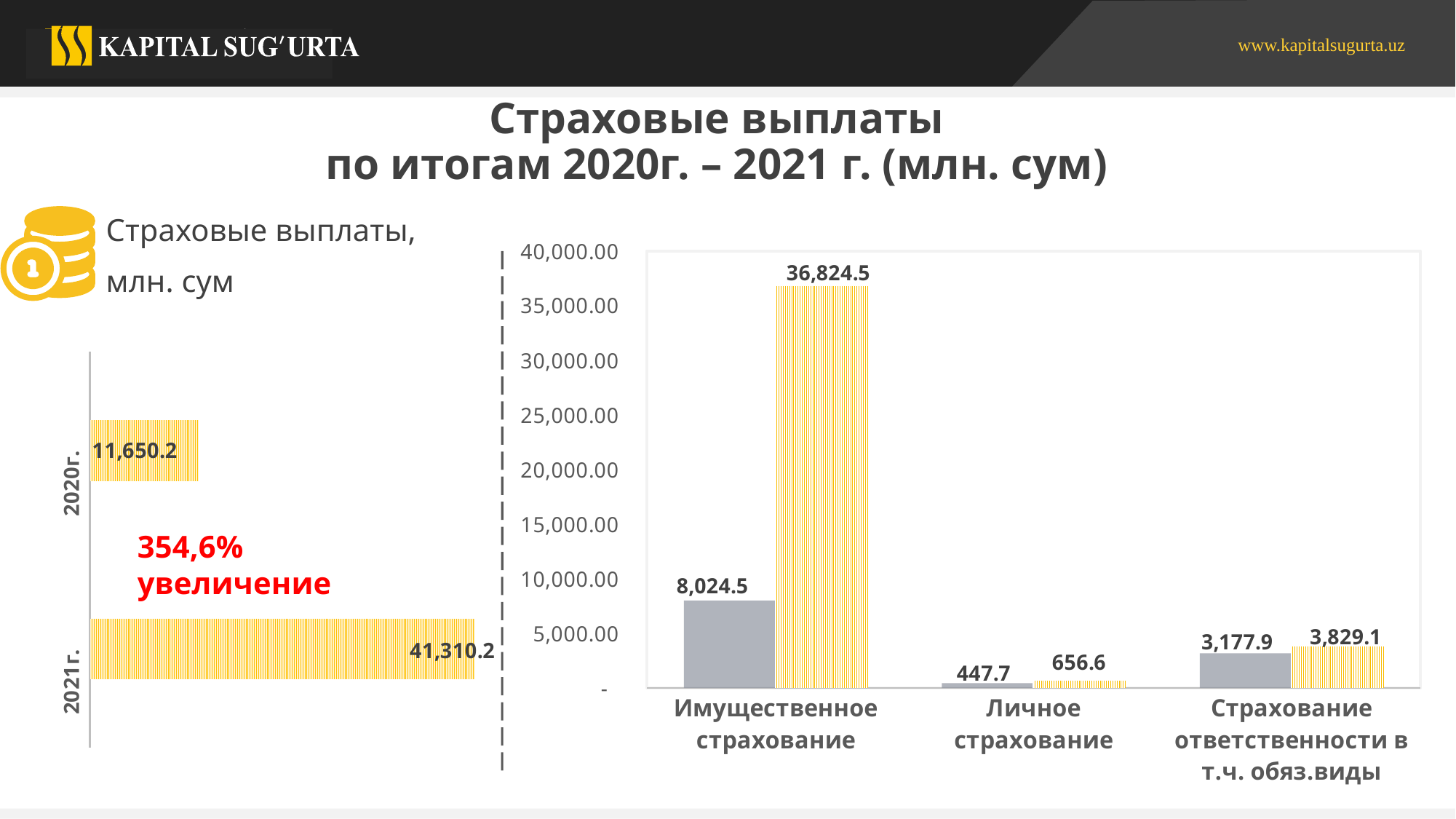
On the left chart, what is the difference between the 2021г. and 2020г. values? 29,660.0 On the right chart, what is the value of the yellow striped bar for Имущественное страхование? 36,824.5 On the right chart, what is the difference between the yellow striped bar and the grey bar for Имущественное страхование? 28,800.0 On the left chart, what is the value for 2021г.? 41,310.2 On the right chart, what is the value of the yellow striped bar for Страхование ответственности в т.ч. обяз.виды? 3,829.1 On the right chart, how many categories are shown on the x axis? 3 What kind of chart is the left chart? Bar chart On the right chart, which category has the highest value? Имущественное страхование On the right chart, is the grey bar for Имущественное страхование greater or less than 10,000.00? less On the left chart, which year has the larger value, 2020г. or 2021г.? 2021г. On the right chart, what is the value of the grey bar for Личное страхование? 447.7 On the left chart, what is the value for 2020г.? 11,650.2